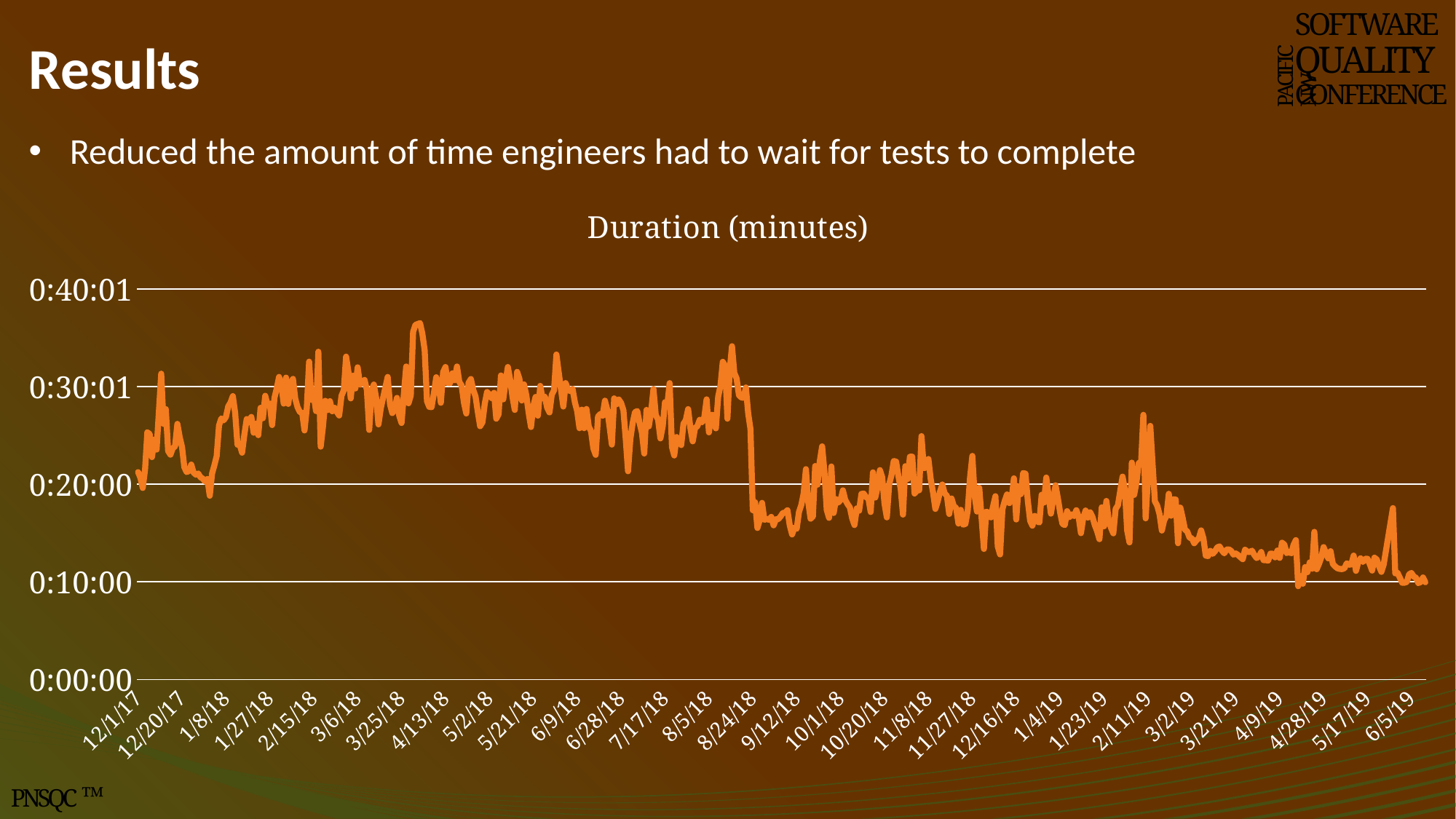
What is the title of the chart? Duration (minutes) Which is larger, the value at 6/9/18 or the value at 5/17/19? 6/9/18 Overall, do the values rise or fall from left to right along the x axis? fall Is the highest point of the line greater or less than 0:40:01? less Is the value at 3/21/19 greater or less than 0:20:00? less What kind of chart is shown on the slide? line chart How many date labels are shown on the x axis? 30 Is the value at 9/12/18 greater or less than 0:20:00? less What is the first date label on the x axis? 12/1/17